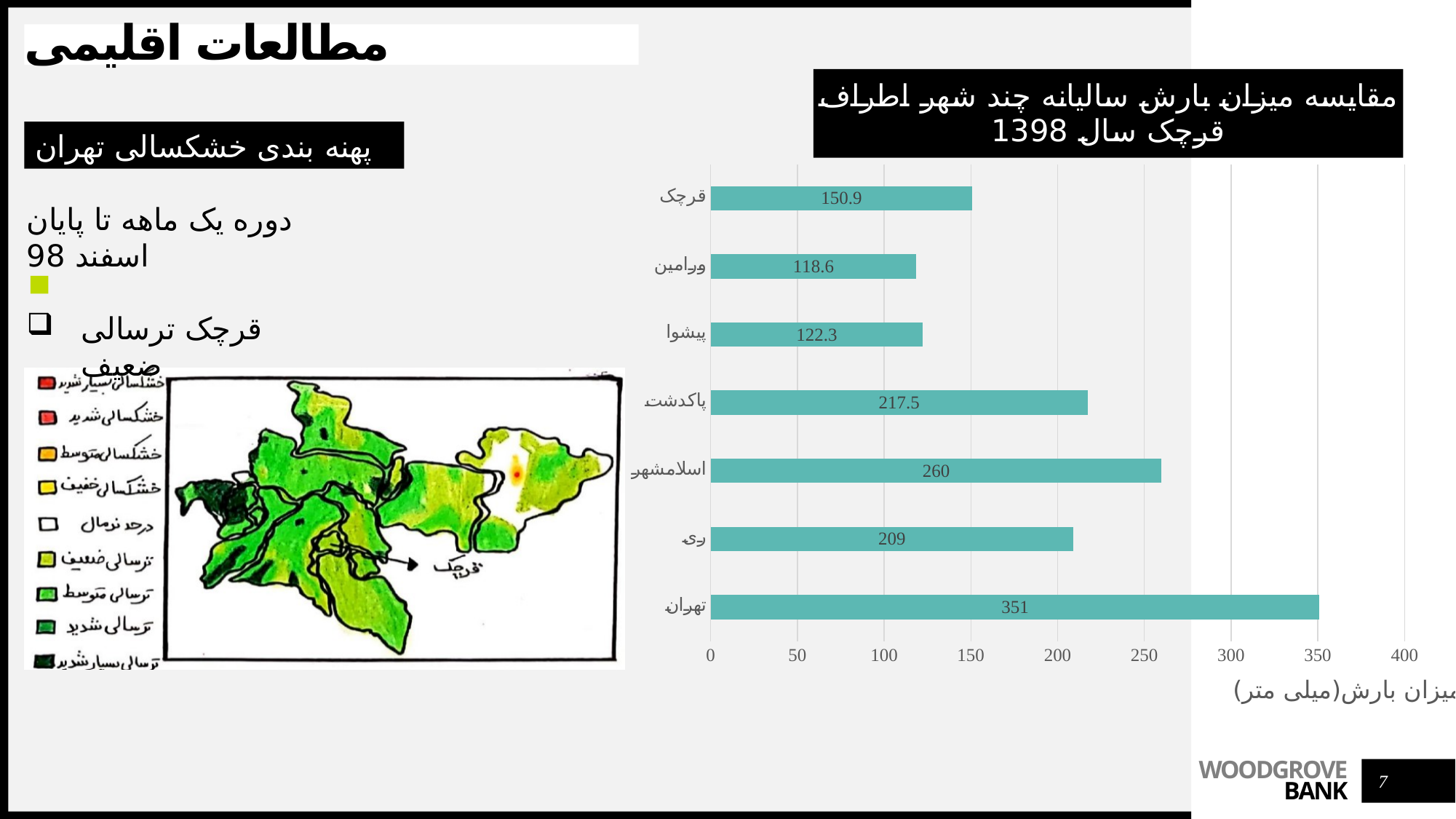
Which city has the highest rainfall value in the bar chart? تهران What is the difference between the values for تهران and قرچک in the bar chart? 200.1 Is the value for اسلامشهر in the bar chart greater or less than 250? greater Which has a larger value in the bar chart, پیشوا or ورامین? پیشوا What is the annual rainfall value shown for تهران in the bar chart? 351 What is the value shown for پاکدشت in the bar chart? 217.5 What is the value shown for قرچک in the bar chart? 150.9 What kind of chart is used to compare the rainfall of the cities? bar chart What is the label of the horizontal axis of the bar chart? میزان بارش(میلی متر) How many cities are shown in the bar chart? 7 What is the difference between the values for اسلامشهر and ری in the bar chart? 51 Which city has the lowest rainfall value in the bar chart? ورامین